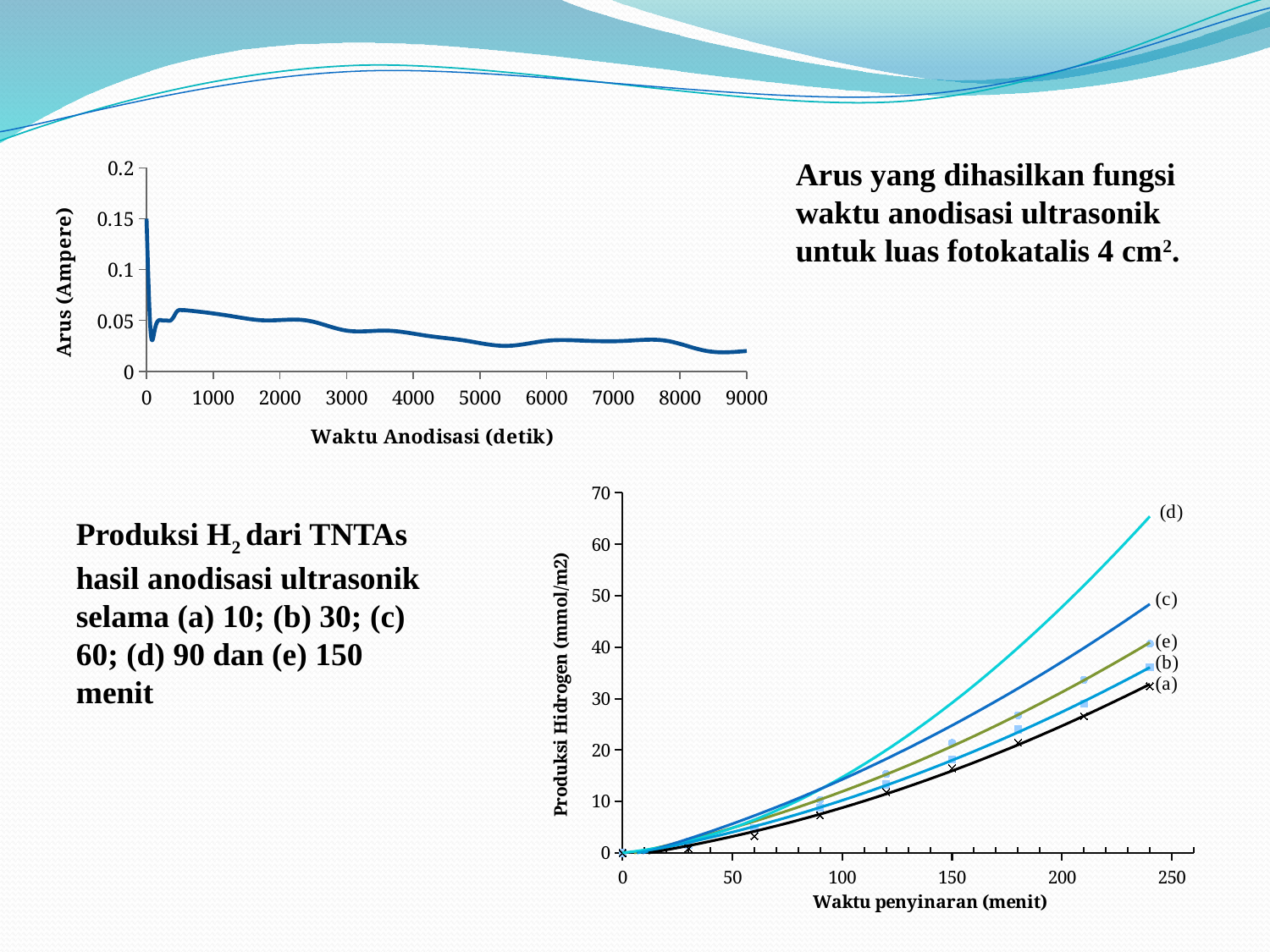
What kind of chart is the bottom-right chart (Produksi Hidrogen vs Waktu penyinaran)? line chart In the bottom-right chart, which series has the highest hydrogen production at 240 minutes? (d) In the top-left chart, is the initial peak current near 0 seconds greater or less than 0.1 Ampere? greater In the bottom-right chart, at 240 minutes, which series has the larger hydrogen production, (c) or (e)? (c) In the bottom-right chart, does hydrogen production rise or fall as irradiation time increases? rise In the bottom-right chart, is the hydrogen production of series (d) at 240 minutes greater or less than 60 mmol/m2? greater In the top-left chart, what is the label of the y axis? Arus (Ampere) In the bottom-right chart, which series has the lowest hydrogen production at 240 minutes? (a) In the top-left chart, does the current generally rise or fall as anodisation time increases from 1000 to 9000 seconds? fall How many series (curves) are plotted in the bottom-right hydrogen production chart? 5 What kind of chart is the top-left chart (Arus vs Waktu Anodisasi)? line chart In the top-left chart, is the current at 9000 seconds greater or less than 0.05 Ampere? less